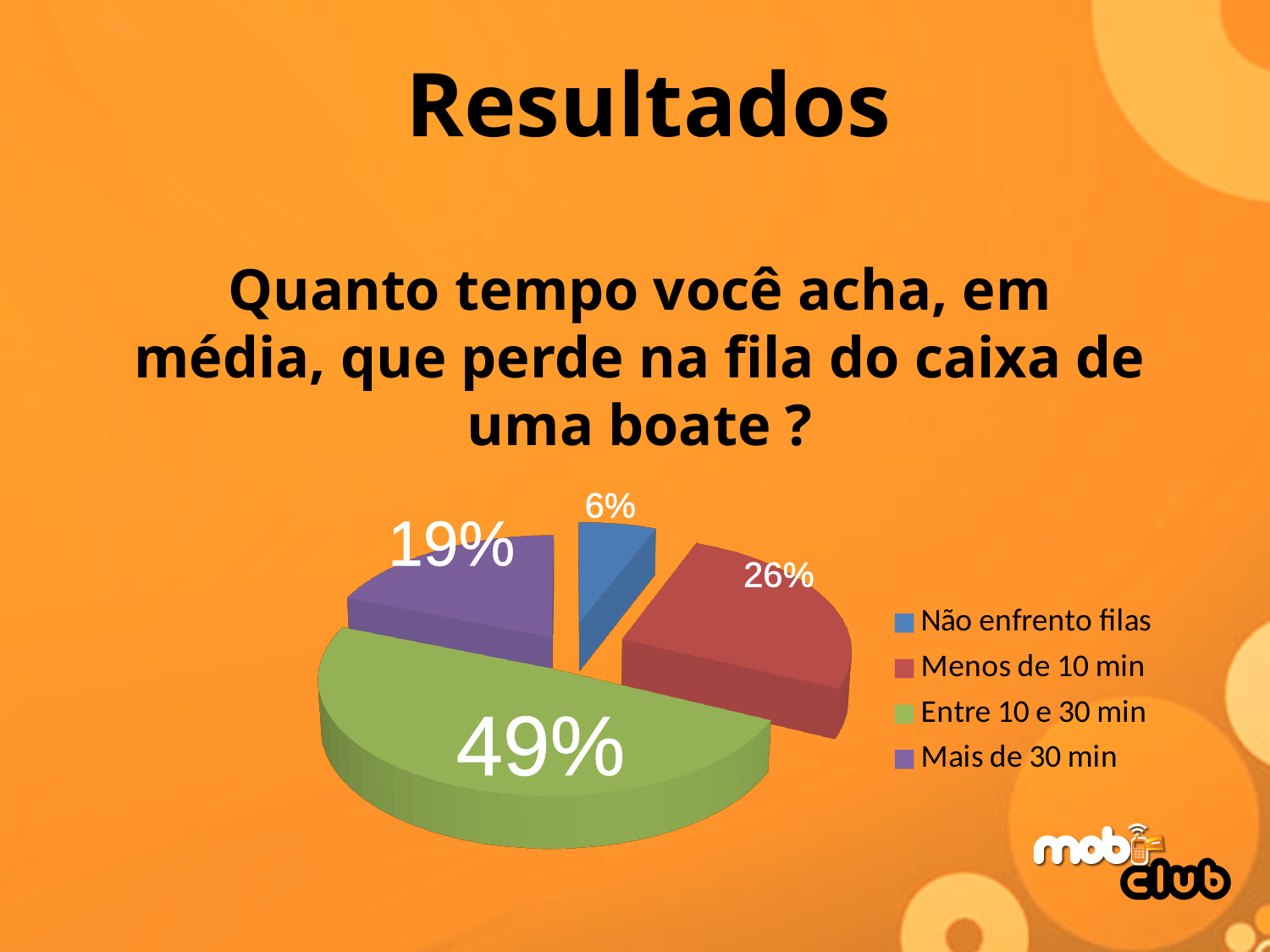
Which category has the largest share of the pie? Entre 10 e 30 min What kind of chart is shown on the slide? pie chart What percentage of respondents answered "Não enfrento filas"? 6% What is the difference in percentage points between "Entre 10 e 30 min" and "Menos de 10 min"? 23 What percentage of respondents answered "Entre 10 e 30 min"? 49% What colour is the slice for "Mais de 30 min"? purple How many categories does the pie chart have? 4 Which category has the smallest share of the pie? Não enfrento filas What percentage of respondents answered "Menos de 10 min"? 26% What question does the chart present results for? Quanto tempo você acha, em média, que perde na fila do caixa de uma boate ? What percentage of respondents answered "Mais de 30 min"? 19% Which is larger: the share for "Menos de 10 min" or the share for "Mais de 30 min"? Menos de 10 min